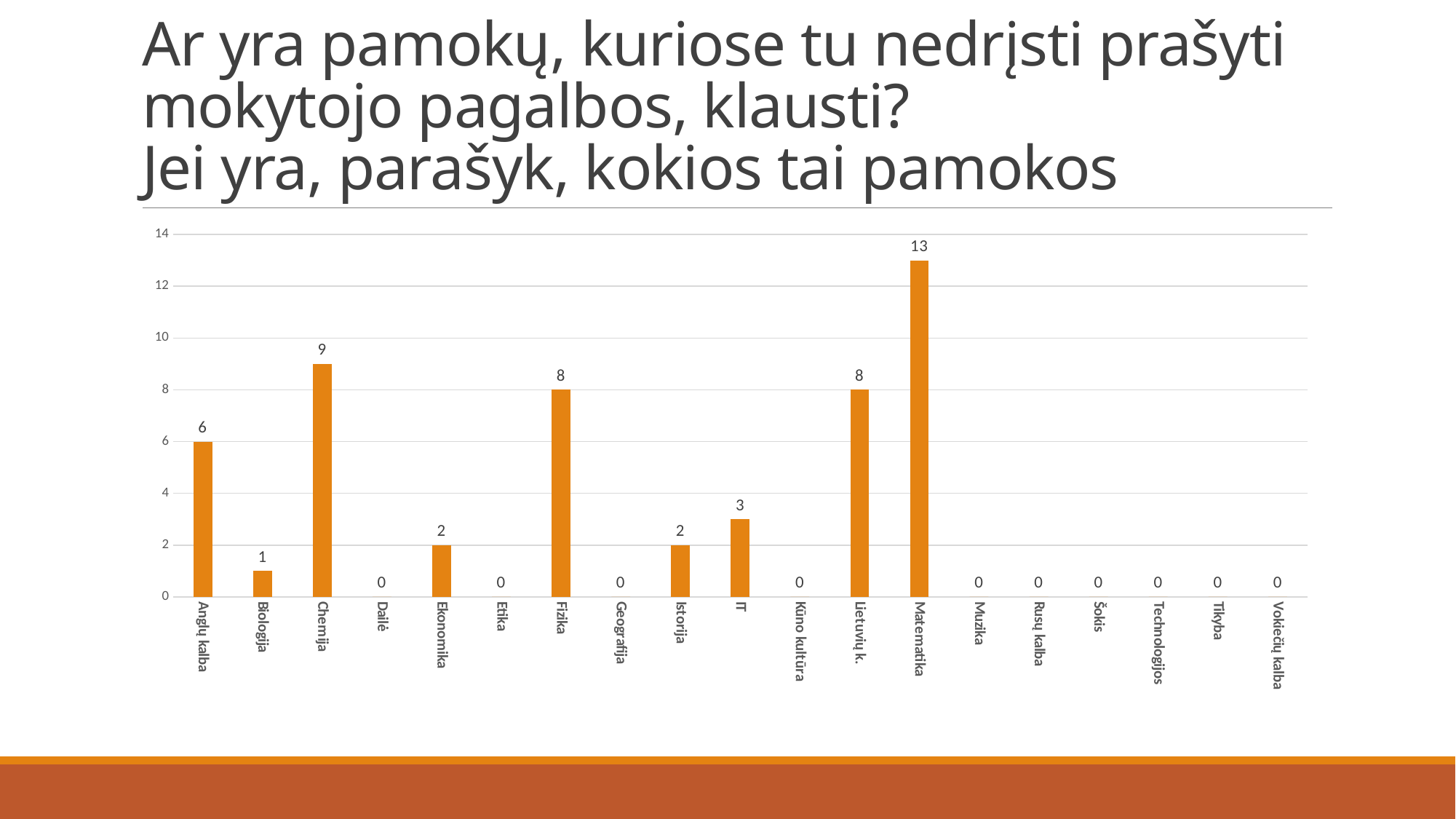
What is the difference between the values for Matematika and Chemija? 4 What is the difference between the values for Fizika and Istorija? 6 Which is larger, the value for Anglų kalba or the value for IT? Anglų kalba What colour are the bars in the chart? Orange What kind of chart is shown on the slide? Bar chart Which category has the highest value? Matematika What is the value for Chemija? 9 How many categories are shown on the x axis? 19 What is the value for Matematika? 13 Is the value for Lietuvių k. greater or less than 6? greater What is the value for IT? 3 What is the value for Anglų kalba? 6